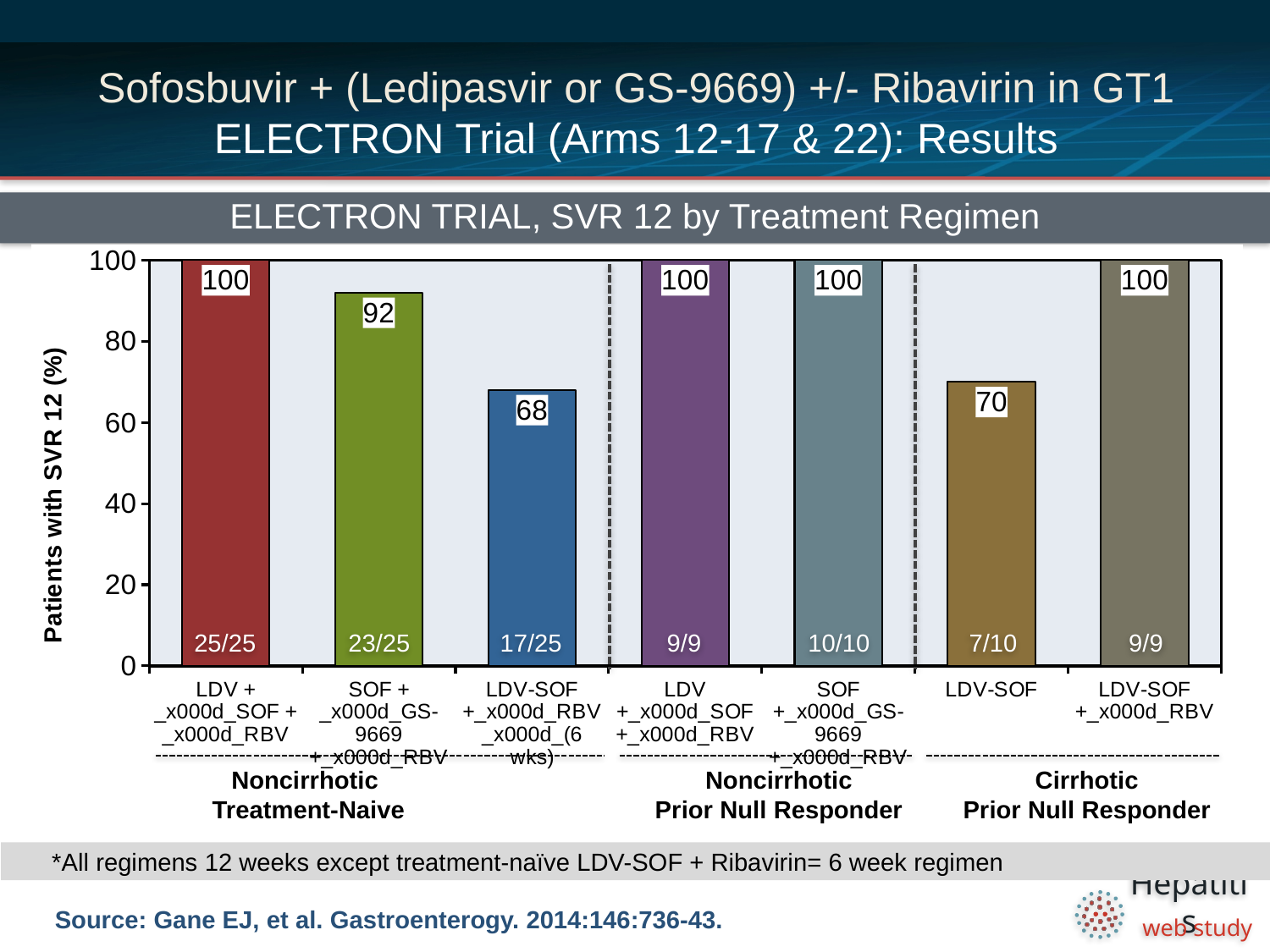
Which regimen has the lowest SVR 12 rate on the chart? LDV-SOF + RBV (6 wks), Noncirrhotic Treatment-Naive What is the label of the y-axis? Patients with SVR 12 (%) What is the SVR 12 rate for LDV-SOF in the Cirrhotic Prior Null Responder group? 70 What is the difference in SVR 12 rate between SOF + GS-9669 + RBV and LDV-SOF + RBV (6 wks) in the Noncirrhotic Treatment-Naive group? 24 In the Cirrhotic Prior Null Responder group, which regimen has the higher SVR 12 rate, LDV-SOF or LDV-SOF + RBV? LDV-SOF + RBV What is the SVR 12 rate for LDV-SOF + RBV (6 wks) in the Noncirrhotic Treatment-Naive group? 68 What is the SVR 12 rate for SOF + GS-9669 + RBV in the Noncirrhotic Treatment-Naive group? 92 How many bars on the chart show an SVR 12 rate of 100? 4 What type of chart is shown on the slide? Bar chart How many patients achieved SVR 12 with SOF + GS-9669 + RBV in the Noncirrhotic Prior Null Responder group, as shown at the base of the bar? 10/10 How many bars are plotted on the chart? 7 What is the title of the chart? ELECTRON TRIAL, SVR 12 by Treatment Regimen